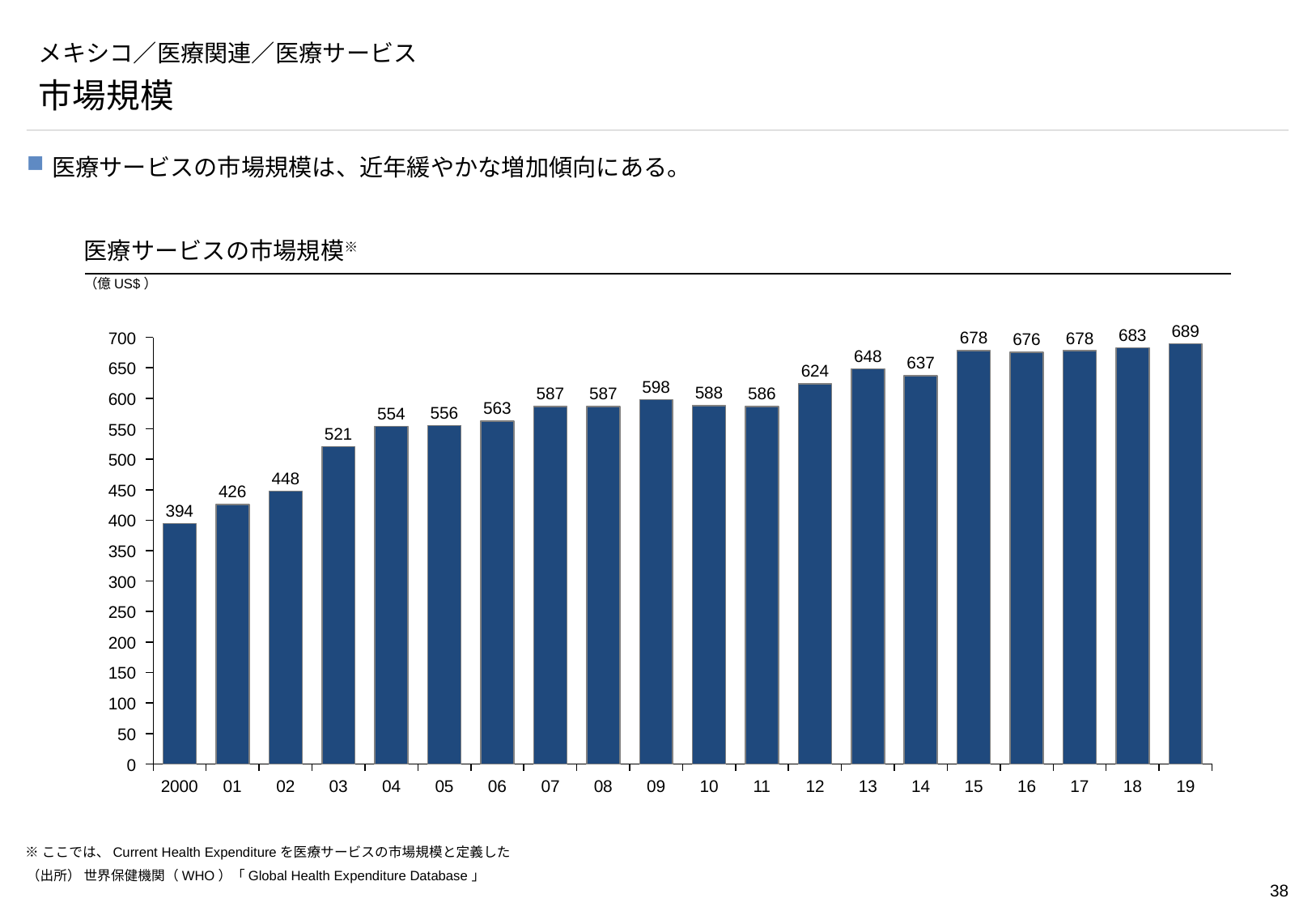
What is the difference between the values for 13 and 14? 11 Is the value for 03 greater or less than 500? greater What is the value for 19? 689 How many years are shown on the x axis? 20 What is the difference between the values for 19 and 2000? 295 Which year has the highest value? 19 What kind of chart is this? bar chart What is the value for 13? 648 What is the value for 2000? 394 Which is larger, the value for 09 or the value for 10? 09 What unit is shown for the values in the chart? 億US$ Which year has the lowest value? 2000